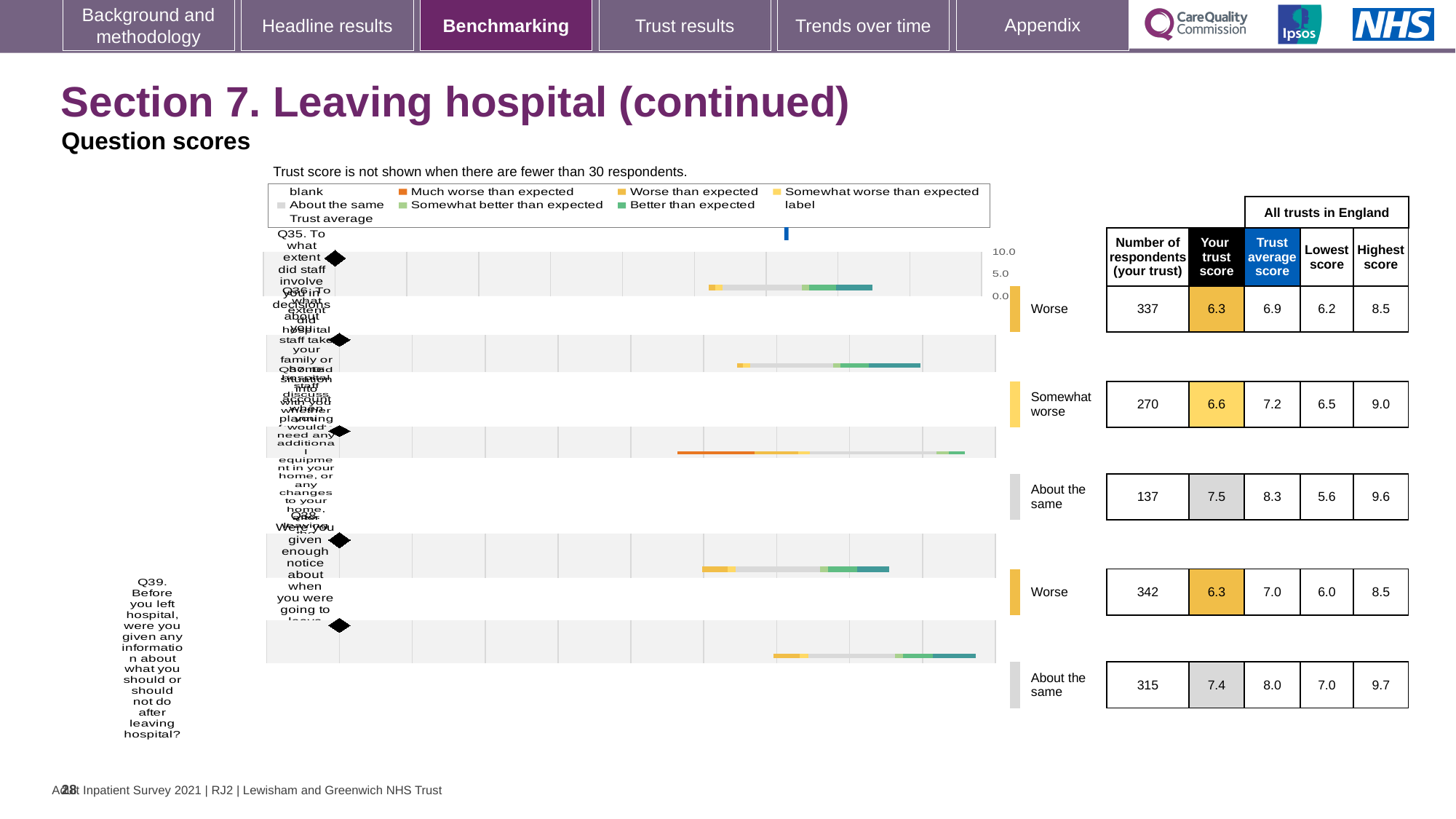
For Q39, how much higher is the trust average score (8.0) than this trust's score (7.4)? 0.6 What is the lowest number of respondents shown for any question in the table? 137 How many respondents answered Q39 at this trust? 315 What is the trust score for Q39 (information about what you should or should not do after leaving hospital)? 7.4 What kind of chart is used to show the question scores on this slide? bar chart What is the trust score for Q35, the first question in the chart? 6.3 For Q35, which is larger: this trust's score or the trust average score? Trust average score What is the highest score across all trusts in England for the second question row (Q36)? 9.0 For the fourth question row (Q38), what is the difference between the highest score (8.5) and the lowest score (6.0)? 2.5 According to the note above the chart, the trust score is not shown when there are fewer than how many respondents? 30 What is the highest 'Your trust score' shown in the table for any of the five questions? 7.5 How many questions (rows) are plotted in the question scores chart? 5